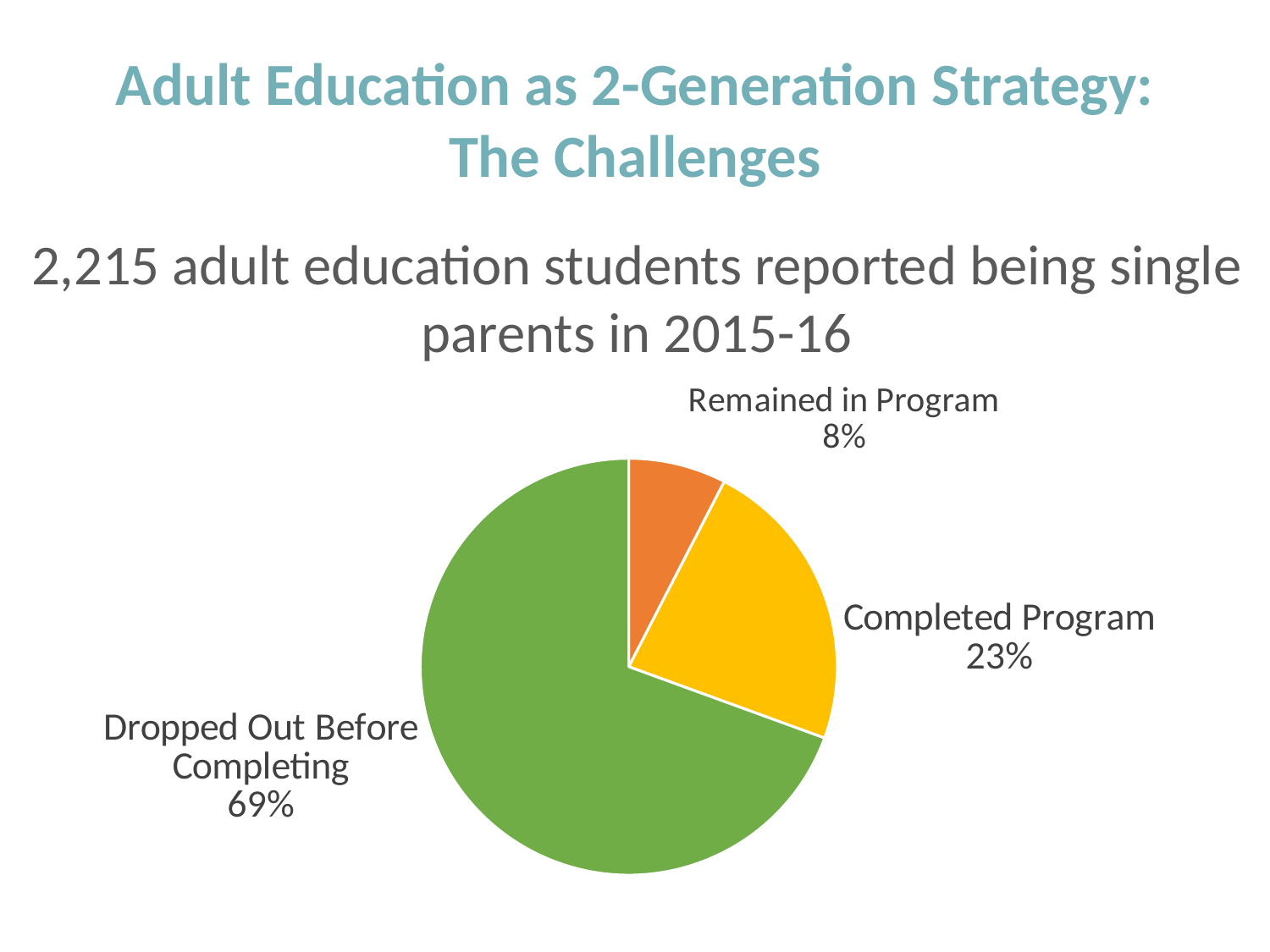
What is the difference in percentage points between Completed Program and Remained in Program? 15 What share of the pie is labelled Remained in Program? 8% How many slices does the pie chart have? 3 What colour is the Dropped Out Before Completing slice? green How many adult education students reported being single parents in 2015-16, according to the slide? 2,215 What kind of chart is shown on the slide? pie chart What share of the pie is labelled Dropped Out Before Completing? 69% Which slice of the pie is the smallest? Remained in Program Which is larger, the share for Completed Program or the share for Remained in Program? Completed Program Which slice of the pie is the largest? Dropped Out Before Completing What is the difference in percentage points between Dropped Out Before Completing and Completed Program? 46 What share of the pie is labelled Completed Program? 23%